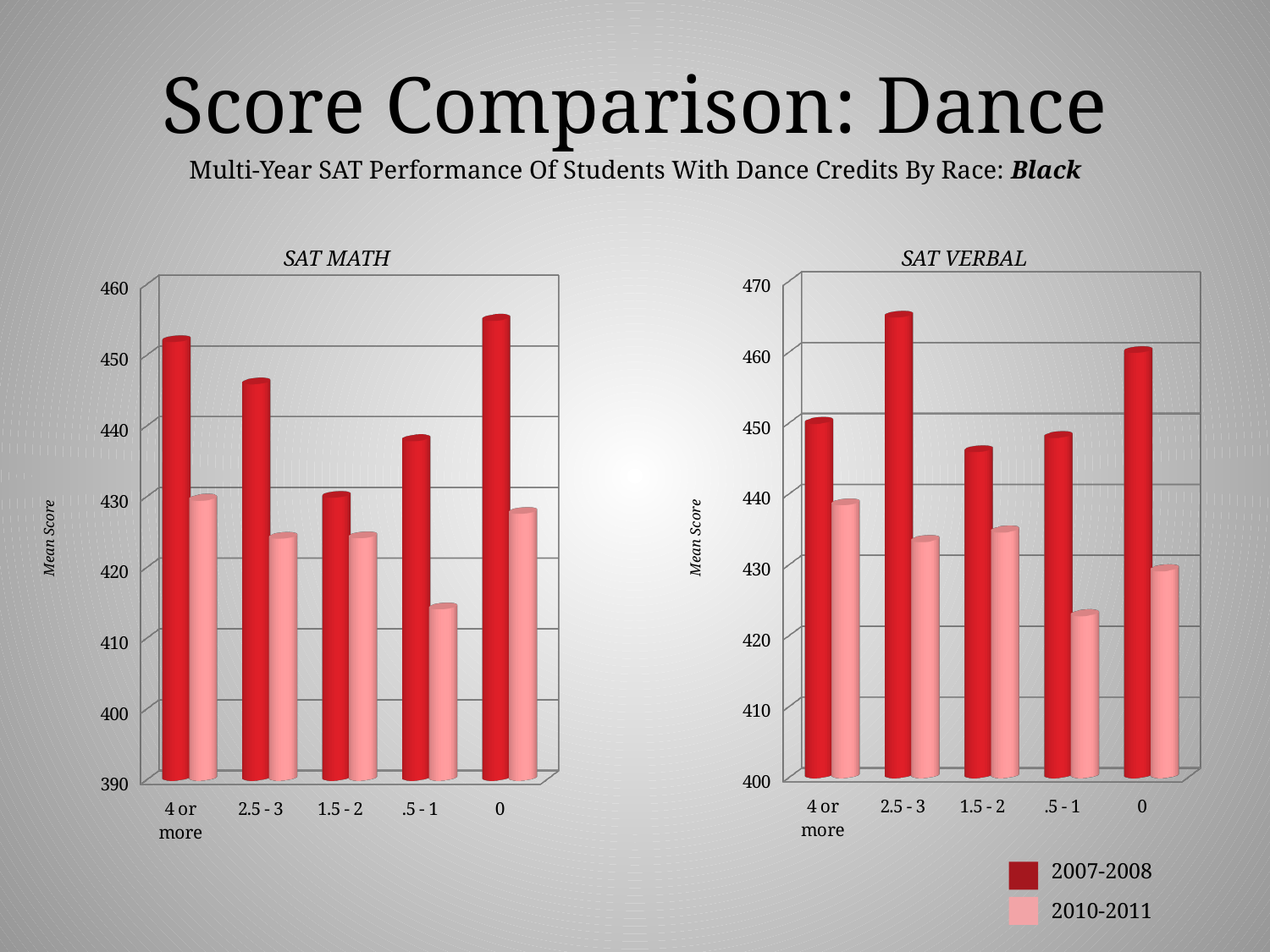
In the SAT VERBAL chart, is the 2010-2011 value for 4 or more greater or less than 430? greater What is the label on the vertical axis of the SAT MATH chart? Mean Score In the SAT MATH chart, is the 2007-2008 value for 1.5 - 2 greater or less than 440? less In the SAT VERBAL chart, which credit category has the highest 2007-2008 score? 2.5 - 3 In the SAT VERBAL chart, which 2010-2011 value is larger, 1.5 - 2 or .5 - 1? 1.5 - 2 In the SAT MATH chart, is the 2010-2011 value for .5 - 1 greater or less than 420? less How many credit categories are shown on the x axis of the SAT VERBAL chart? 5 How many series does the legend list for the charts? 2 In the SAT MATH chart, for the 4 or more category, which series has the larger value, 2007-2008 or 2010-2011? 2007-2008 In the SAT MATH chart, which credit category has the lowest 2010-2011 score? .5 - 1 What kind of chart is the SAT MATH chart? bar chart